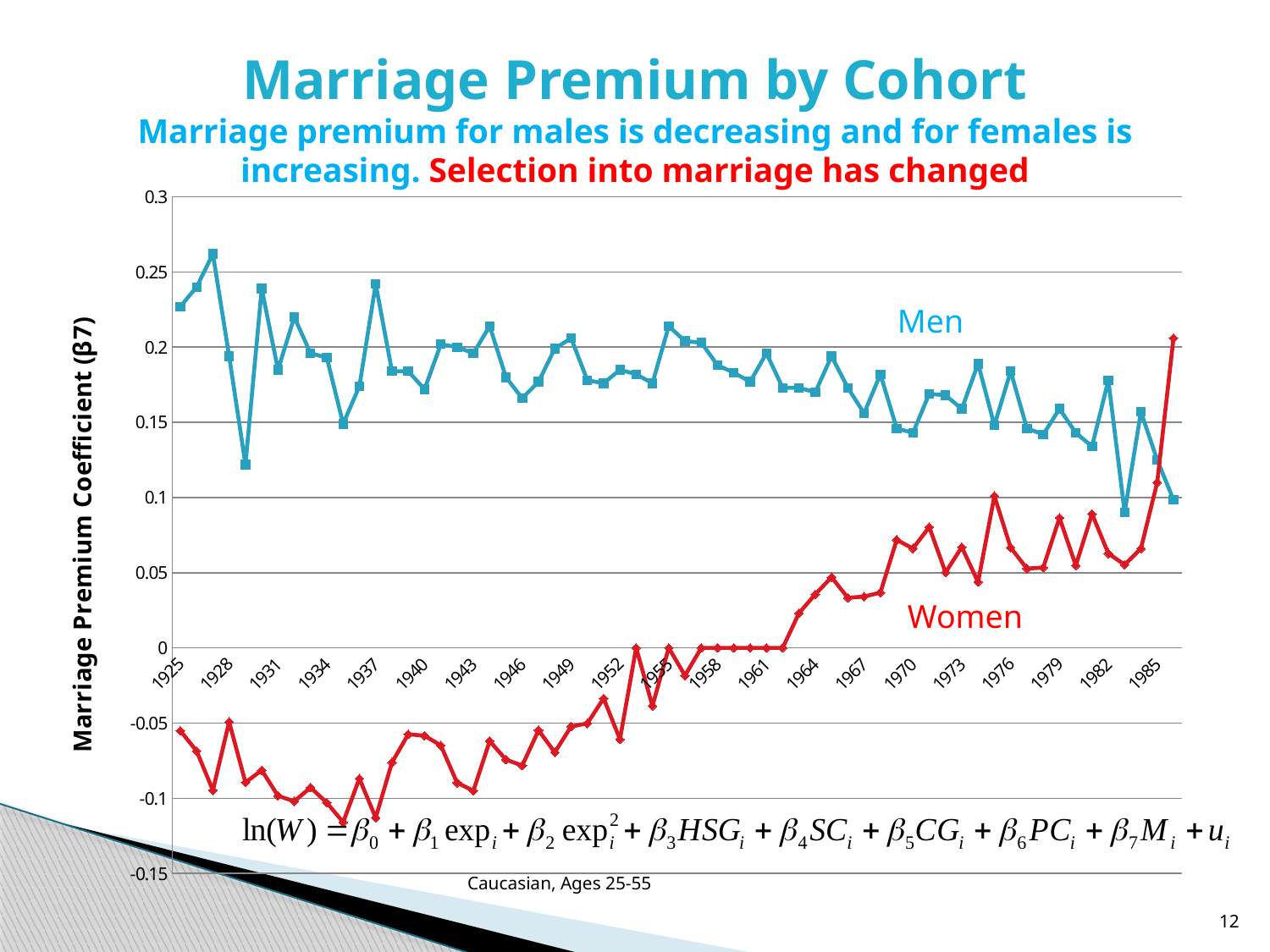
What is the label of the vertical axis? Marriage Premium Coefficient (β7) What kind of chart is shown on the slide? line chart Is the value for Men at 1937 greater or less than 0.2? greater Does the Men series generally rise or fall from 1925 to 1985? fall Is the value for Women at 1970 greater or less than 0.05? greater Does the Women series generally rise or fall from 1925 to 1985? rise At 1925, which series has the larger value, Men or Women? Men How many data series are plotted on the chart? 2 Is the value for Women at 1925 greater or less than 0? less Which two series are labelled on the chart? Men and Women